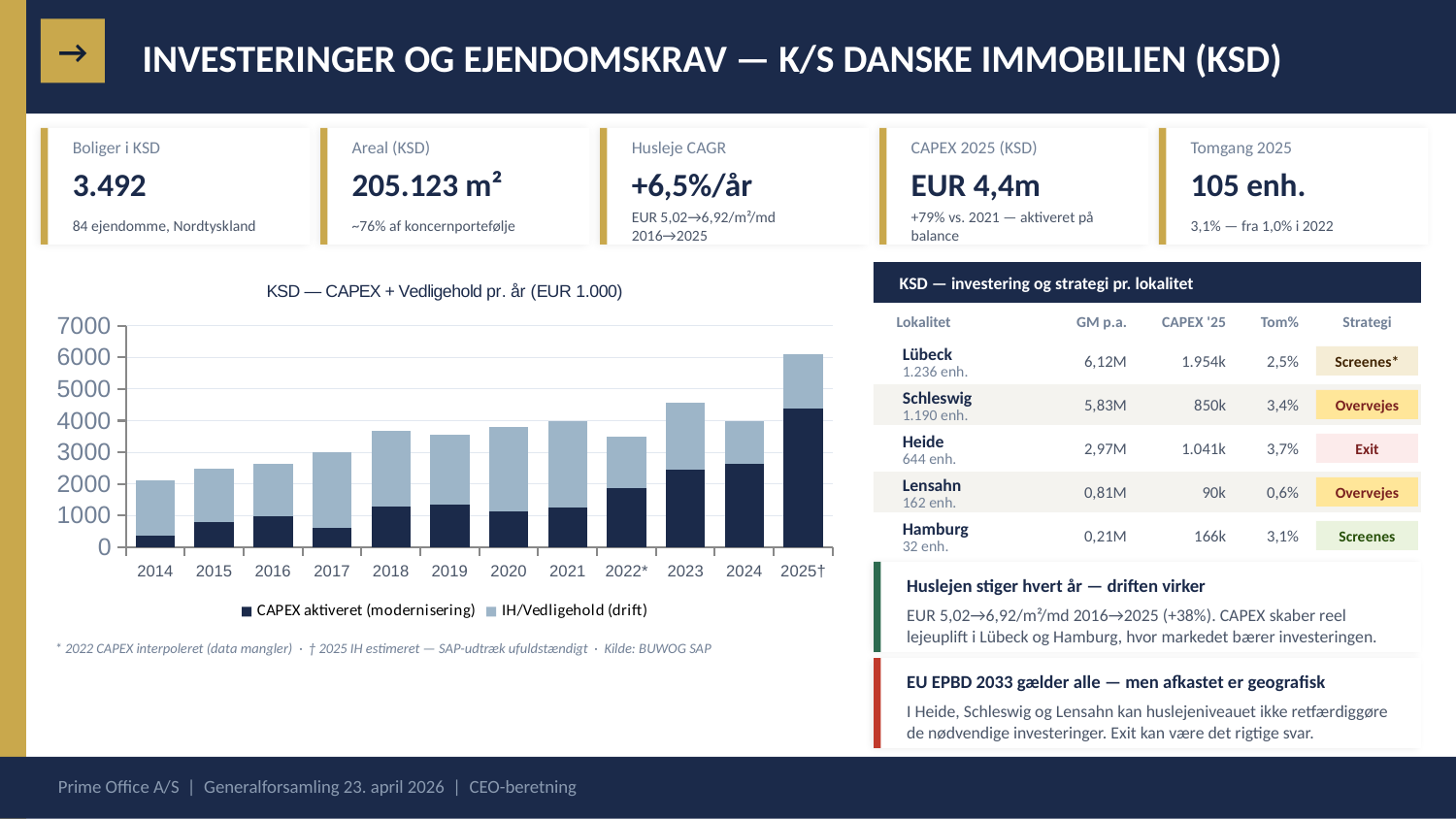
Which year has the highest total bar in the chart? 2025† Is the total bar for 2014 greater or less than 3000? less What is the title of the chart? KSD — CAPEX + Vedligehold pr. år (EUR 1.000) How many series does the chart legend list? 2 Do the total bars generally rise or fall from 2014 to 2025†? rise What kind of chart is shown on the slide? Stacked bar chart How many years are shown on the x axis of the chart? 12 Which year has the lowest total bar in the chart? 2014 Is the CAPEX aktiveret (modernisering) value for 2025† greater or less than 4000? greater Is the CAPEX aktiveret (modernisering) value for 2014 greater or less than 1000? less Which year has the larger total bar, 2023 or 2022*? 2023